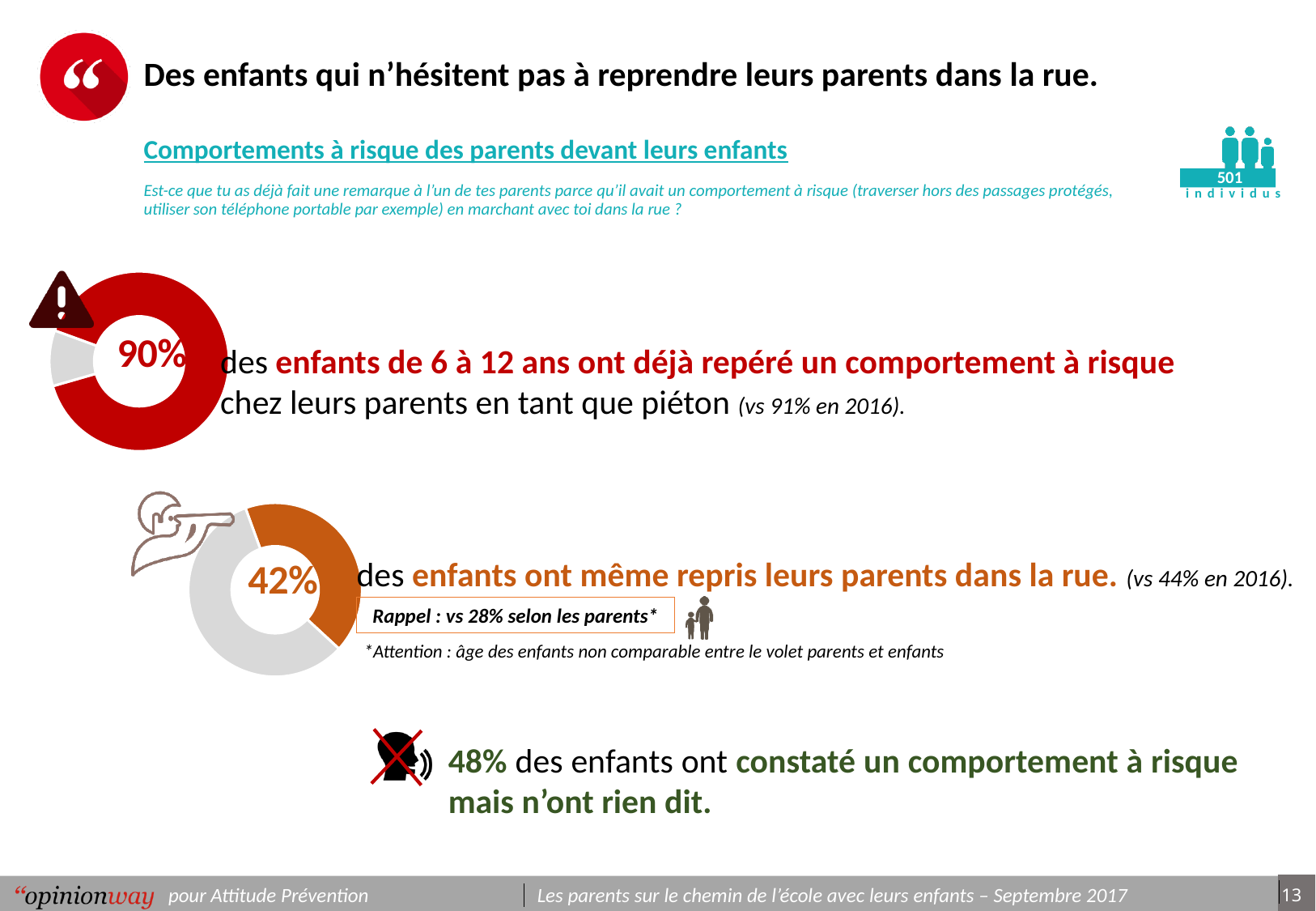
In the top donut chart, what share of the ring is taken by the red slice? 90% Is the value shown in the top donut chart greater or less than 80%? greater What is the difference between the value shown in the top donut chart and the value shown in the lower donut chart? 48 percentage points Which chart shows the larger highlighted share: the top donut chart (90%) or the lower donut chart (42%)? The top donut chart In the lower donut chart, what share of the ring is taken by the orange slice? 42% What colour is the highlighted slice in the top donut chart? Red What colour is the highlighted slice in the lower donut chart? Orange In the top donut chart, what percentage is printed in the centre? 90% In the lower donut chart, what percentage is printed in the centre? 42% Is the value shown in the lower donut chart greater or less than 50%? less What kind of chart is the lower chart on the slide, next to the pointing-person icon? Donut (pie) chart What kind of chart is the top chart on the slide, next to the warning triangle icon? Donut (pie) chart